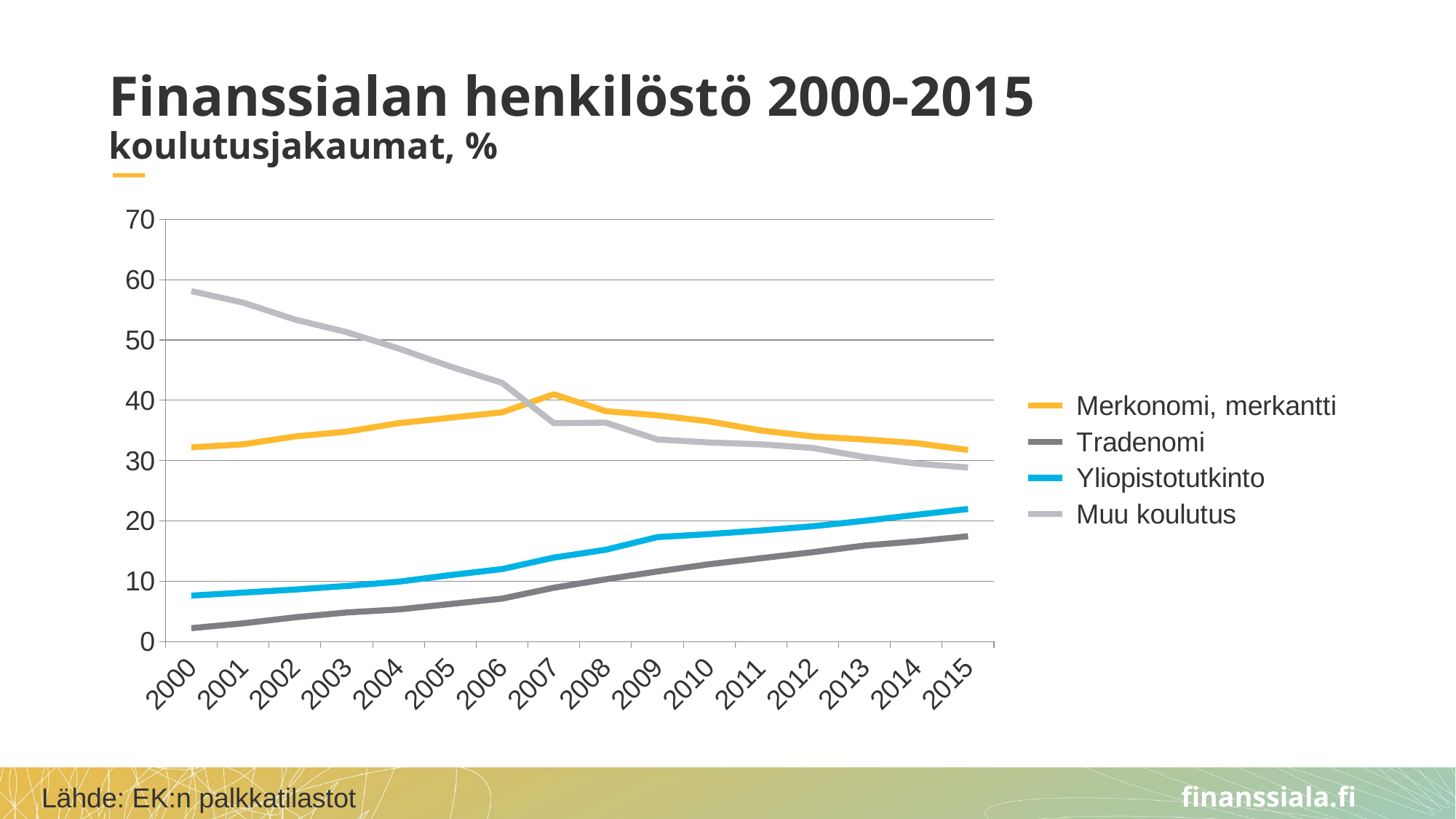
Is the value for Tradenomi in 2000 greater or less than 10? less Does the Tradenomi line rise or fall from 2000 to 2015? rise How many years are shown on the x axis? 16 Is the value for Muu koulutus in 2000 greater or less than 50? greater How many series does the legend list? 4 Is the value for Yliopistotutkinto in 2015 greater or less than 20? greater In 2007, which is larger: Merkonomi, merkantti or Muu koulutus? Merkonomi, merkantti Does the Muu koulutus line rise or fall from 2000 to 2015? fall What kind of chart is shown on the slide? line chart Which series has the lowest value in 2015? Tradenomi Which series has the highest value in 2000? Muu koulutus Does the Yliopistotutkinto line rise or fall from 2000 to 2015? rise